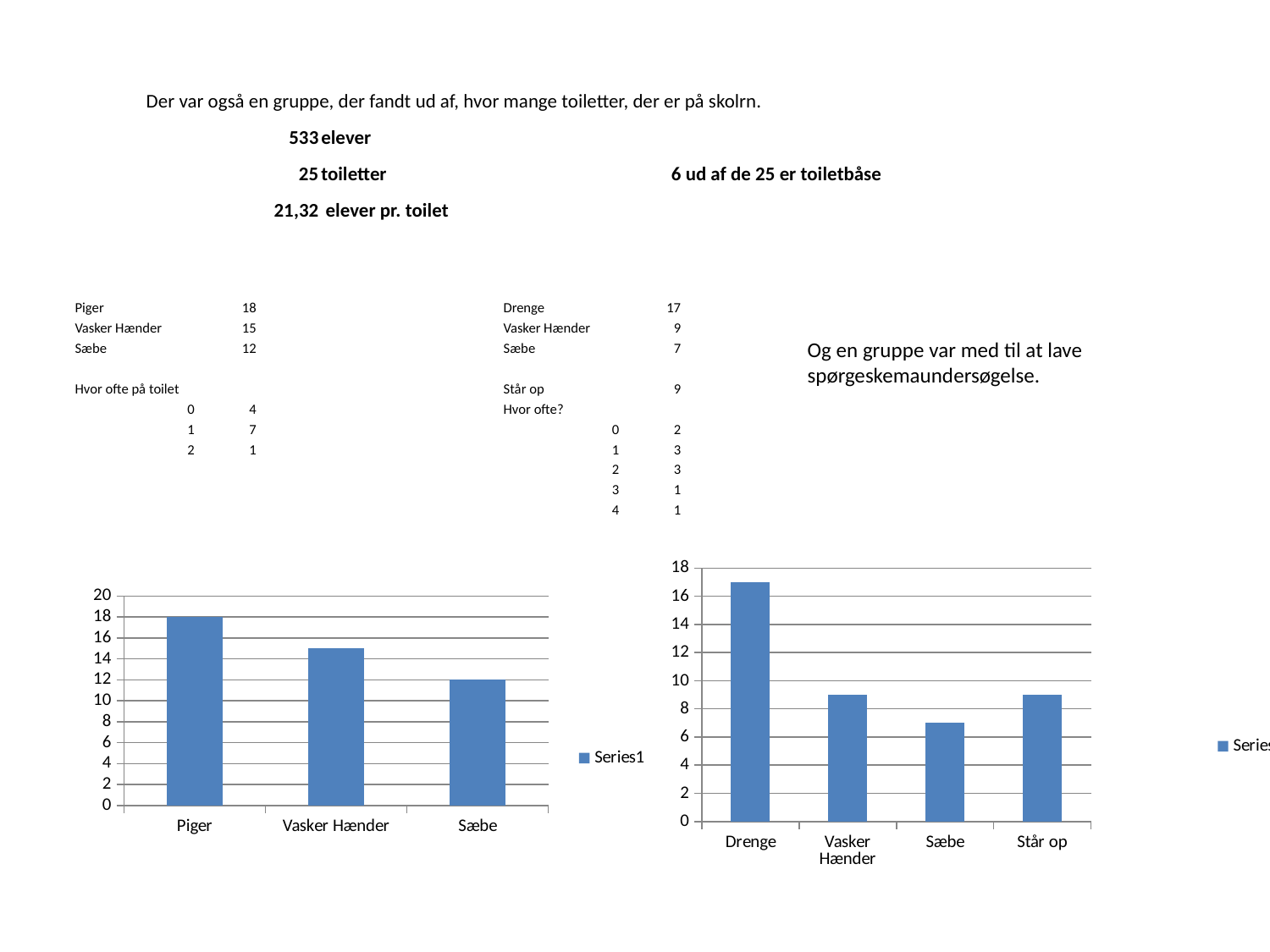
What kind of chart is the right chart? bar chart In the left chart, how many categories are shown on the x axis? 3 In the left chart, what is the value for Sæbe? 12 In the left chart, which category has the highest value? Piger In the left chart, what is the value for Piger? 18 In the left chart, what is the difference between the values for Piger and Sæbe? 6 In the right chart, is the value for Drenge greater or less than 16? greater In the left chart, is the value for Vasker Hænder greater or less than 14? greater In the right chart, which category has the highest value? Drenge In the right chart, how many categories are shown on the x axis? 4 In the right chart, which category has the lowest value? Sæbe In the left chart, which category has the lowest value? Sæbe